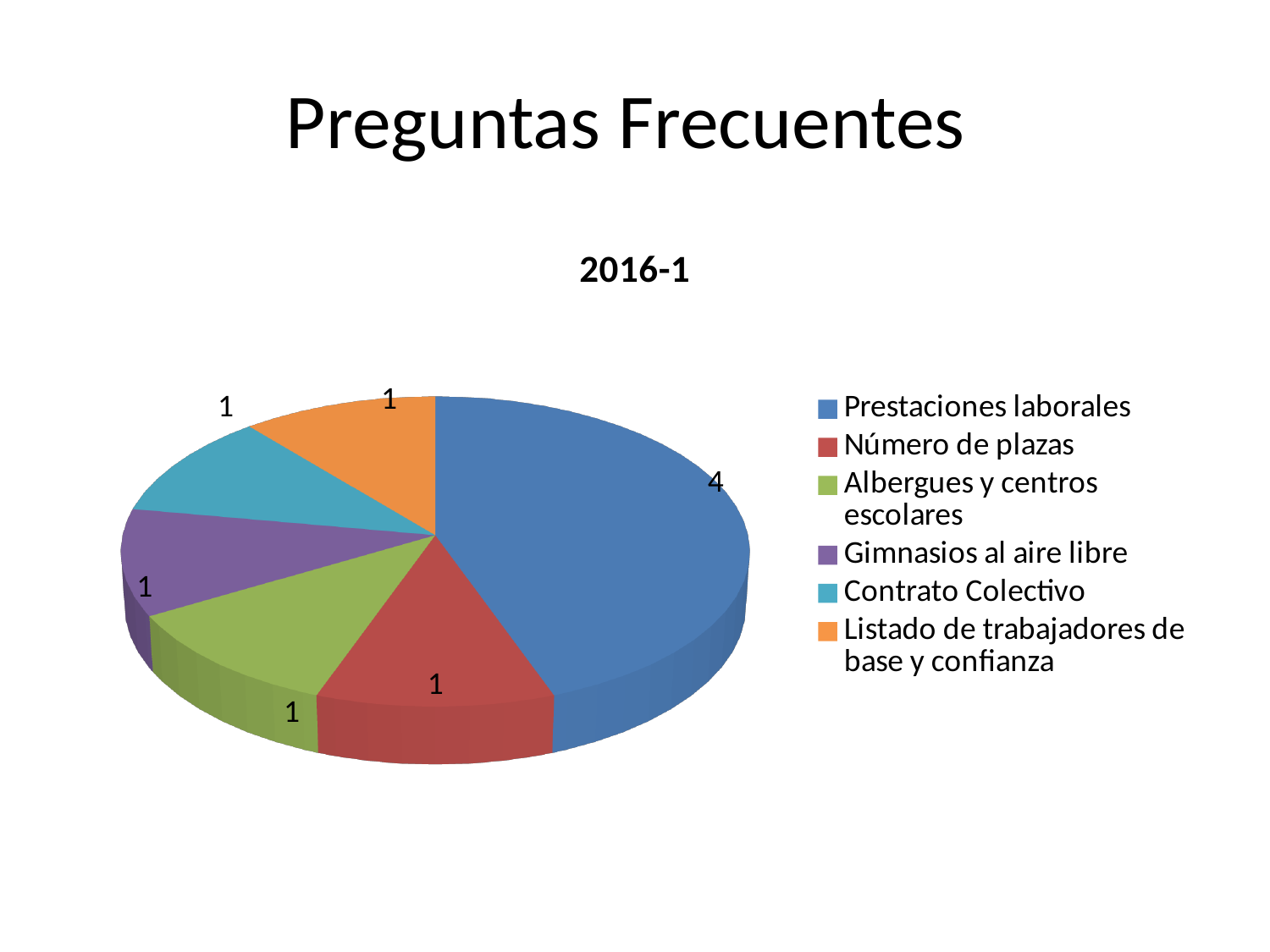
What is the value for Número de plazas? 1 What type of chart is shown on the slide? pie chart What is the title of the chart? 2016-1 What is the difference between the values for Prestaciones laborales and Gimnasios al aire libre? 3 How many entries does the legend list? 6 What is the value for Prestaciones laborales? 4 Which category has the largest slice of the pie? Prestaciones laborales How many slices does the pie chart have? 6 What is the total of all the slice values in the pie chart? 9 What is the value for Contrato Colectivo? 1 What is the value for Listado de trabajadores de base y confianza? 1 Which is larger, the value for Prestaciones laborales or the value for Albergues y centros escolares? Prestaciones laborales